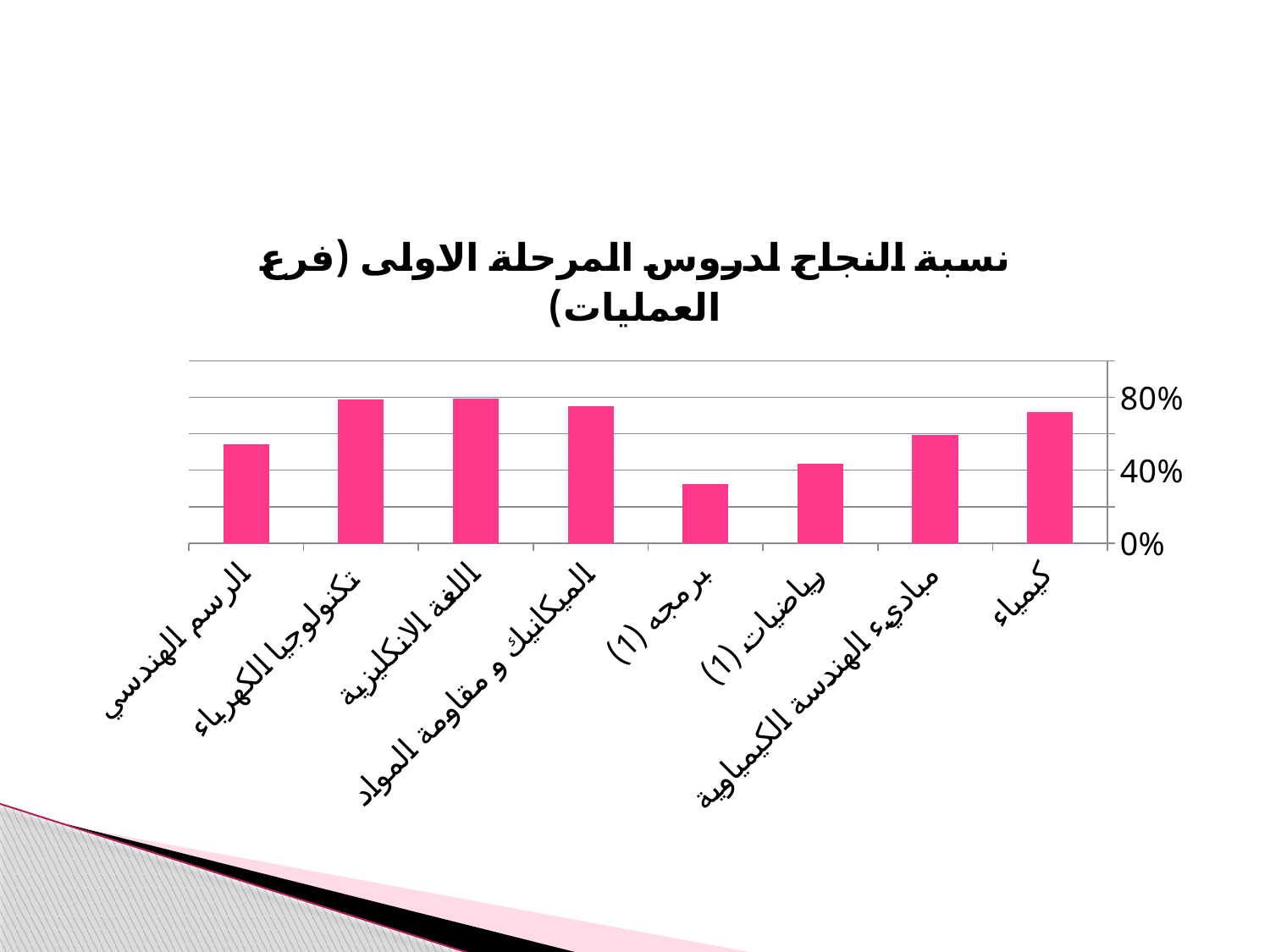
Which is larger, the value for كيمياء or the value for برمجه (1)? كيمياء Is the value for الميكانيك و مقاومة المواد greater or less than 40%? greater What is the title of the chart? نسبة النجاح لدروس المرحلة الاولى (فرع العمليات) Which is larger, the value for الرسم الهندسي or the value for رياضيات (1)? الرسم الهندسي Is the value for كيمياء greater or less than 80%? less What kind of chart is shown on the slide? Bar chart Is the value for مبادىء الهندسة الكيمياوية greater or less than 40%? greater How many categories (bars) does the chart show? 8 Which category has the lowest value in the chart? برمجه (1) What colour are the bars in the chart? Pink